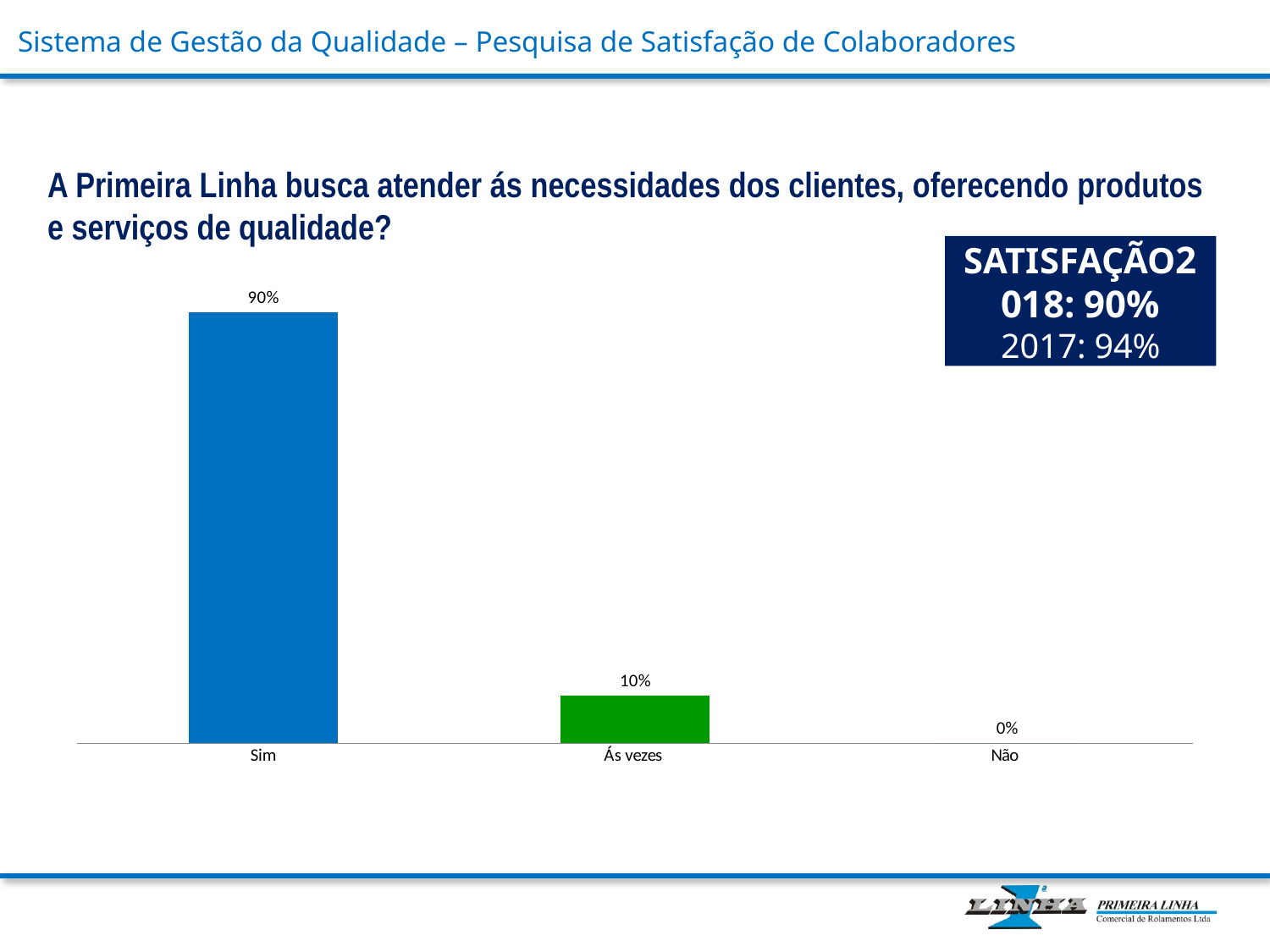
What is the difference between the values for Sim and Ás vezes? 80% What is the value for Ás vezes? 10% Which is larger, the value for Ás vezes or the value for Não? Ás vezes How many categories are shown on the x axis? 3 Which category has the highest value? Sim What is the value for Sim? 90% What kind of chart is shown on the slide? bar chart What colour is the bar for Ás vezes? green Which category has the lowest value? Não What colour is the bar for Sim? blue Do the values rise or fall from left to right along the x axis? fall What is the value for Não? 0%